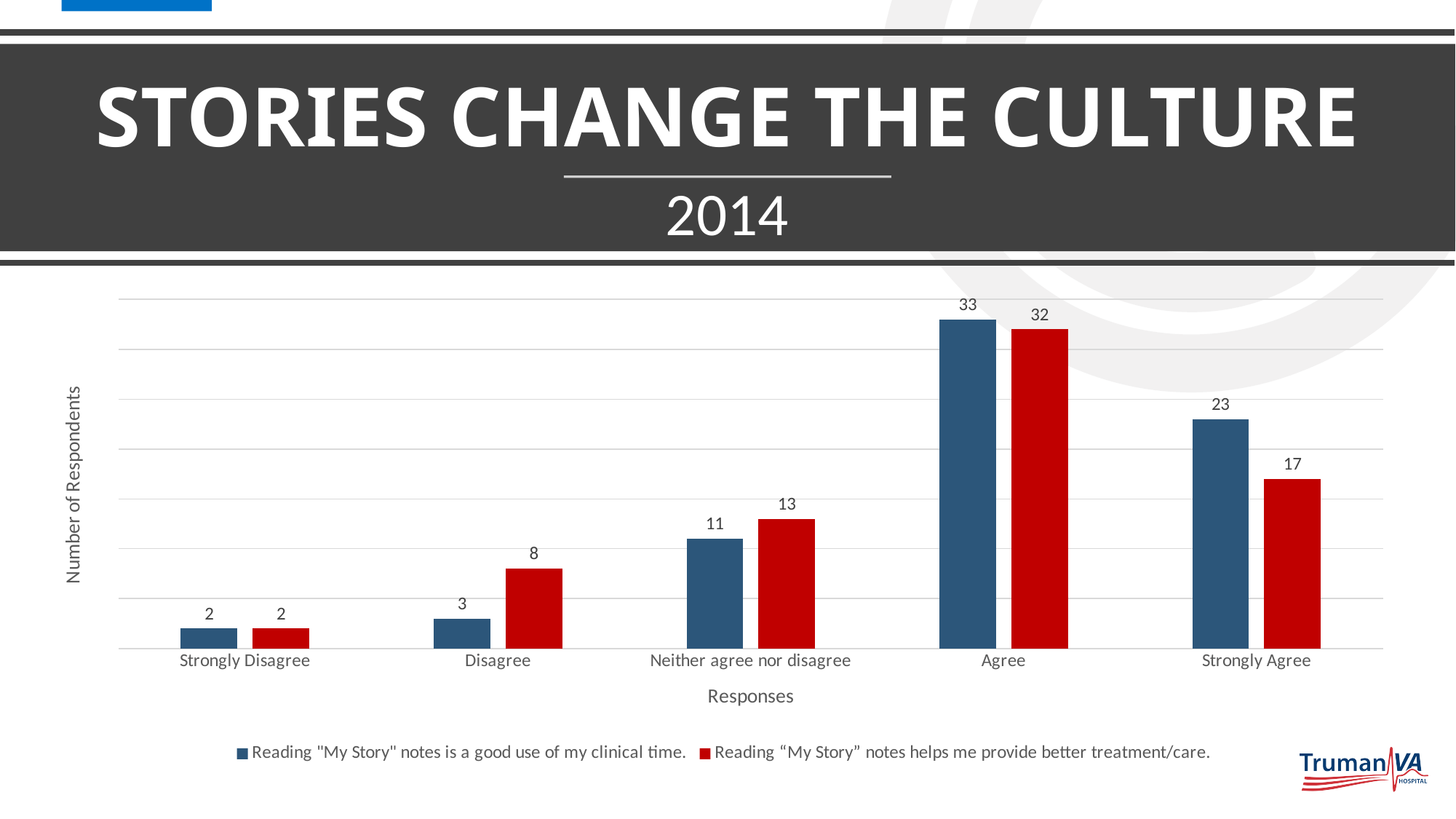
How many response categories are shown on the x axis? 5 For "Neither agree nor disagree", which statement has more respondents? Reading "My Story" notes helps me provide better treatment/care. Which response category has the highest number of respondents for "Reading "My Story" notes is a good use of my clinical time."? Agree How many series does the legend list? 2 How many respondents chose "Agree" for the statement "Reading "My Story" notes is a good use of my clinical time."? 33 What is the difference between the two series' values for "Strongly Agree"? 6 How many respondents chose "Strongly Agree" for the statement "Reading "My Story" notes helps me provide better treatment/care."? 17 What is the label of the y axis? Number of Respondents How many respondents chose "Disagree" for the statement "Reading "My Story" notes helps me provide better treatment/care."? 8 What kind of chart is shown on the slide? Bar chart Which response category has the lowest number of respondents for "Reading "My Story" notes helps me provide better treatment/care."? Strongly Disagree What is the label of the x axis? Responses